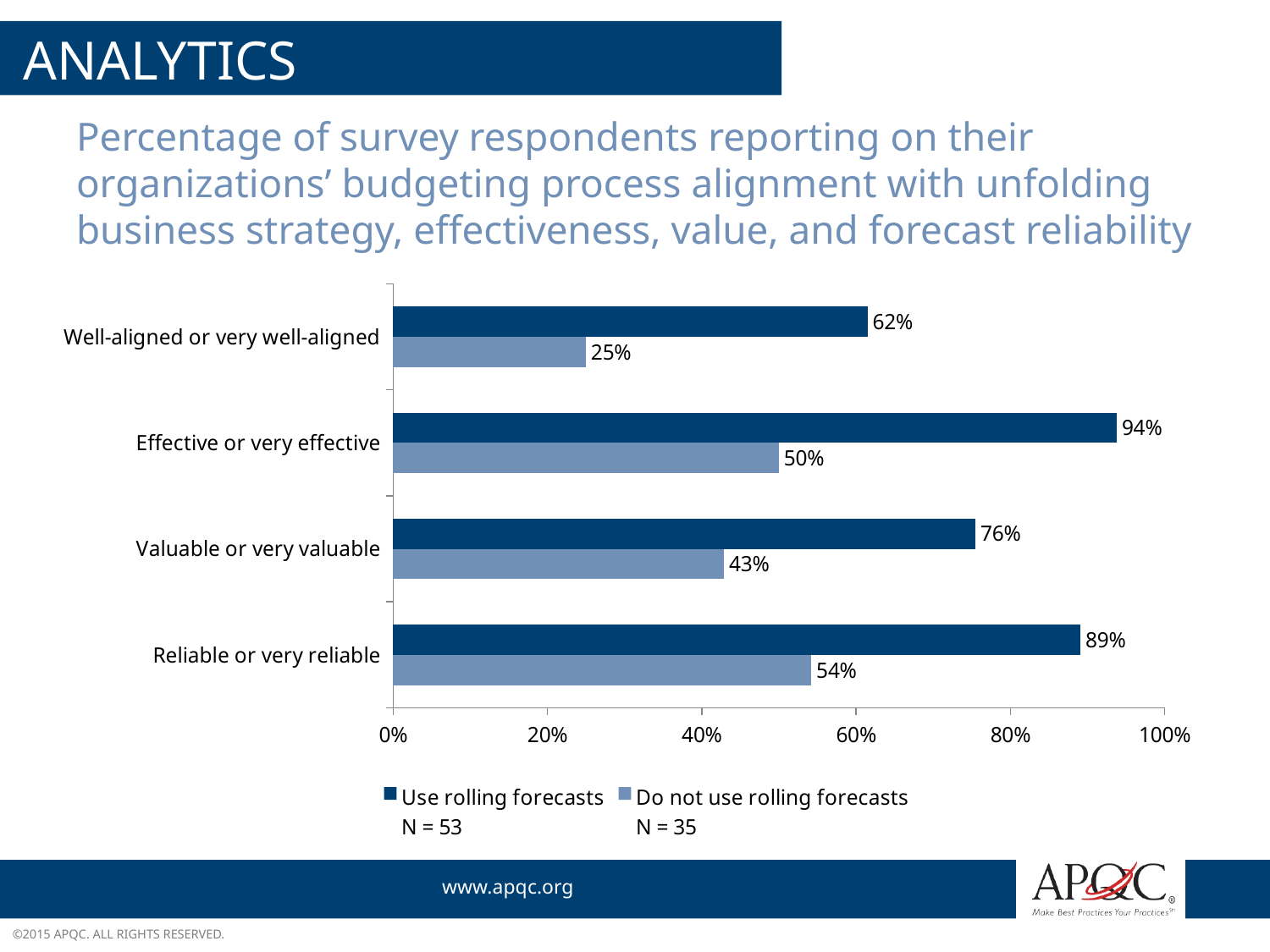
Which category has the highest value for the 'Use rolling forecasts' series? Effective or very effective What percentage of respondents who use rolling forecasts report their budgeting process is effective or very effective? 94% What is the sample size (N) for the 'Use rolling forecasts' group? N = 53 How many categories are shown on the chart? 4 What kind of chart is shown on the slide? Bar chart What is the difference between the 'Use rolling forecasts' and 'Do not use rolling forecasts' values for 'Valuable or very valuable'? 33 percentage points For 'Well-aligned or very well-aligned', which series has the larger value? Use rolling forecasts Which category has the lowest value for the 'Do not use rolling forecasts' series? Well-aligned or very well-aligned What is the sample size (N) for the 'Do not use rolling forecasts' group? N = 35 How many series does the legend list? 2 What is the value for 'Reliable or very reliable' among respondents who do not use rolling forecasts? 54% What percentage of respondents who do not use rolling forecasts report their budgeting process is well-aligned or very well-aligned? 25%